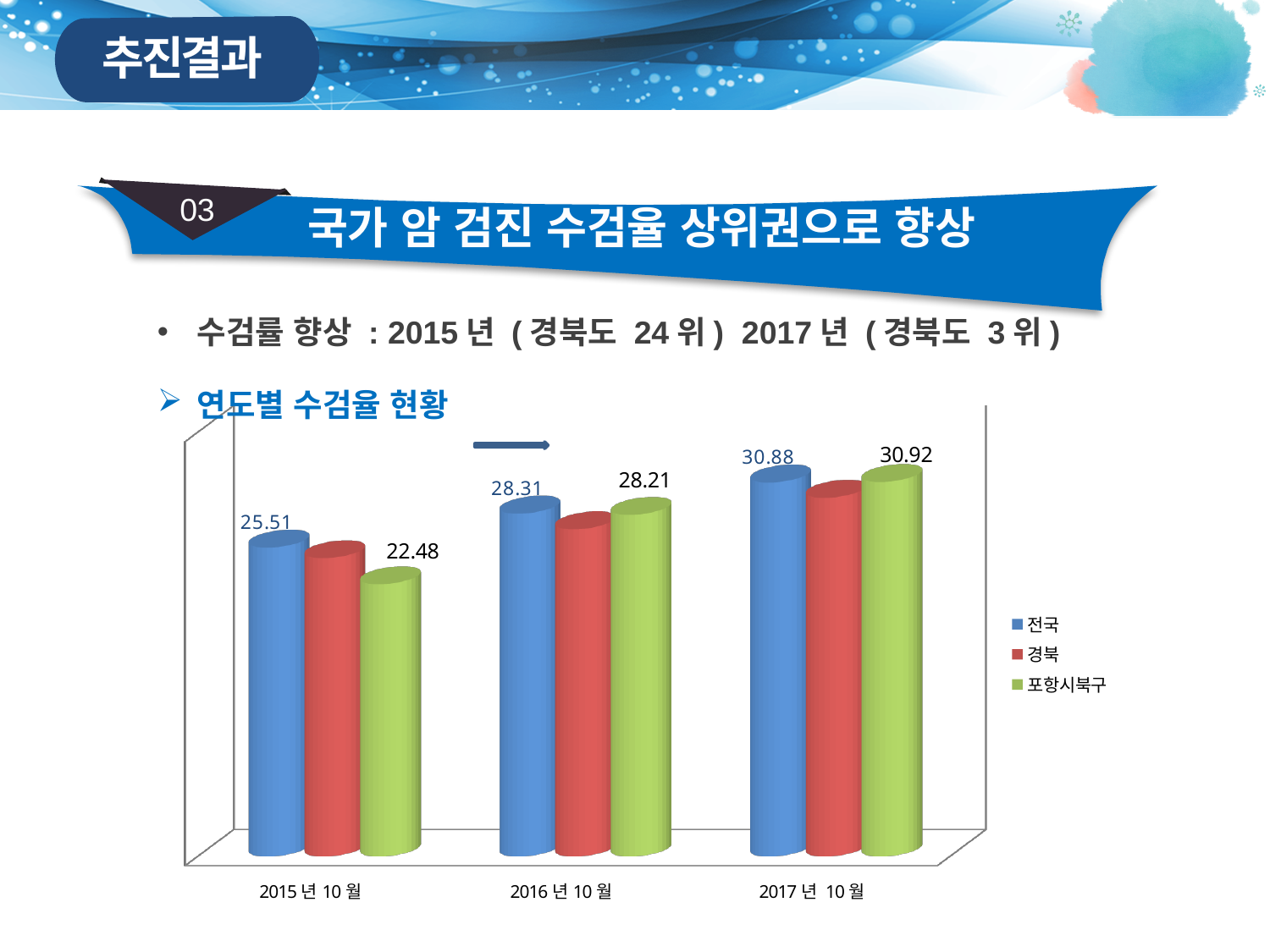
What is the value for 전국 in 2015년 10월? 25.51 In 2015년 10월, which is larger: the value for 전국 or the value for 포항시북구? 전국 In which period is the value for 포항시북구 the lowest? 2015년 10월 What is the value for 포항시북구 in 2016년 10월? 28.21 What is the value for 포항시북구 in 2017년 10월? 30.92 How many series does the legend list? 3 By how much did the 포항시북구 value increase from 2015년 10월 to 2017년 10월? 8.44 What is the value for 전국 in 2017년 10월? 30.88 In which period is the value for 전국 the highest? 2017년 10월 Do the values for 포항시북구 rise or fall from 2015년 10월 to 2017년 10월? Rise What kind of chart is shown on the slide? Bar chart What is the difference between the 전국 value and the 포항시북구 value in 2015년 10월? 3.03